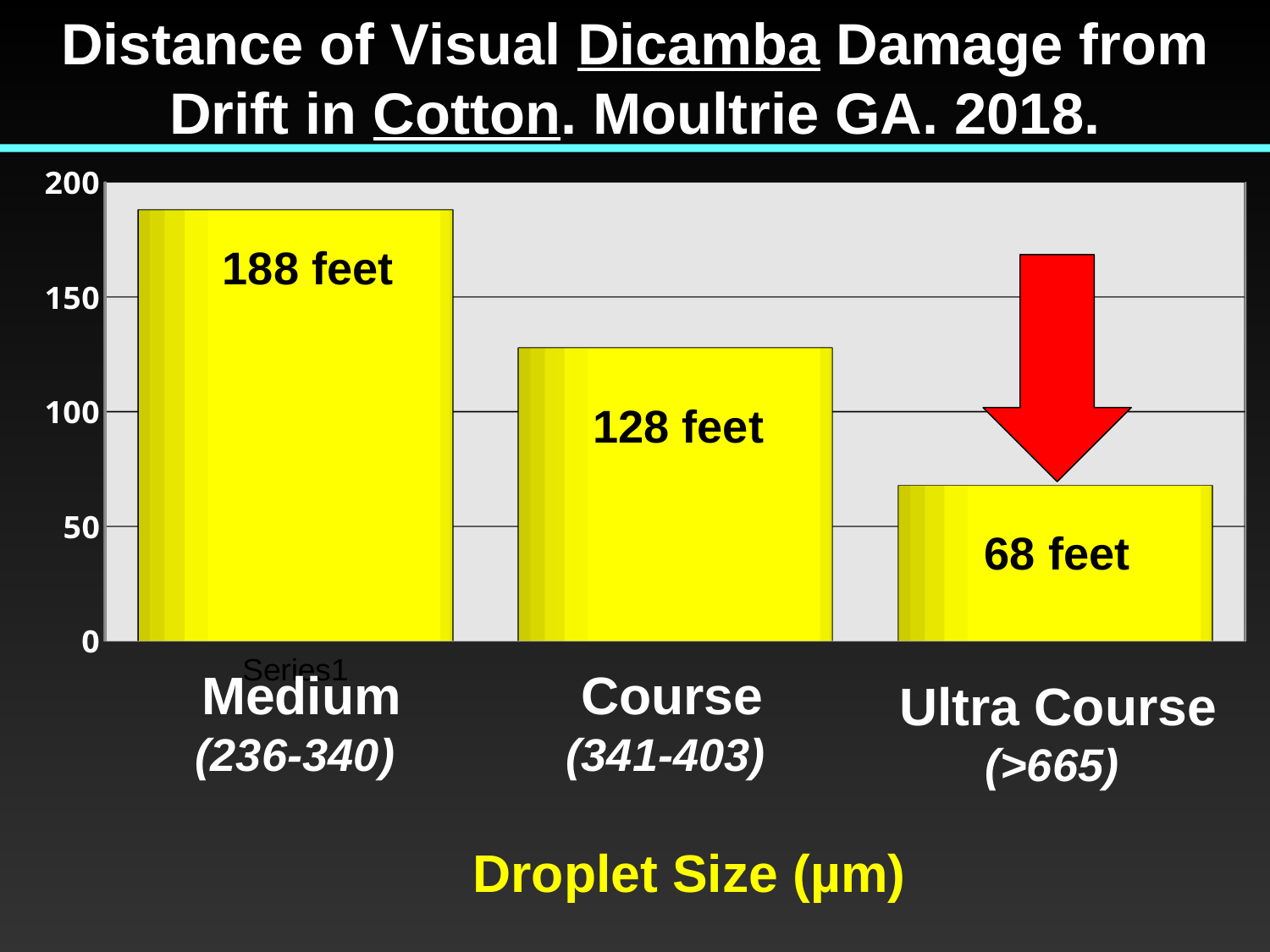
What is the difference in damage distance between the Course and Ultra Course droplet sizes? 60 feet Do the damage distances rise or fall as droplet size increases from Medium to Ultra Course? Fall What kind of chart is shown on the slide? Bar chart Which droplet size category has the smallest distance of visual damage? Ultra Course What is the distance of visual dicamba damage for the Ultra Course droplet size? 68 feet What is the distance of visual dicamba damage for the Course droplet size? 128 feet What is the difference in damage distance between the Medium and Ultra Course droplet sizes? 120 feet What is the distance of visual dicamba damage for the Medium droplet size? 188 feet Which has a larger damage distance, Medium or Course droplets? Medium Which droplet size category has the greatest distance of visual damage? Medium Is the value for Course droplets greater or less than 100? greater How many droplet size categories are shown in the chart? 3